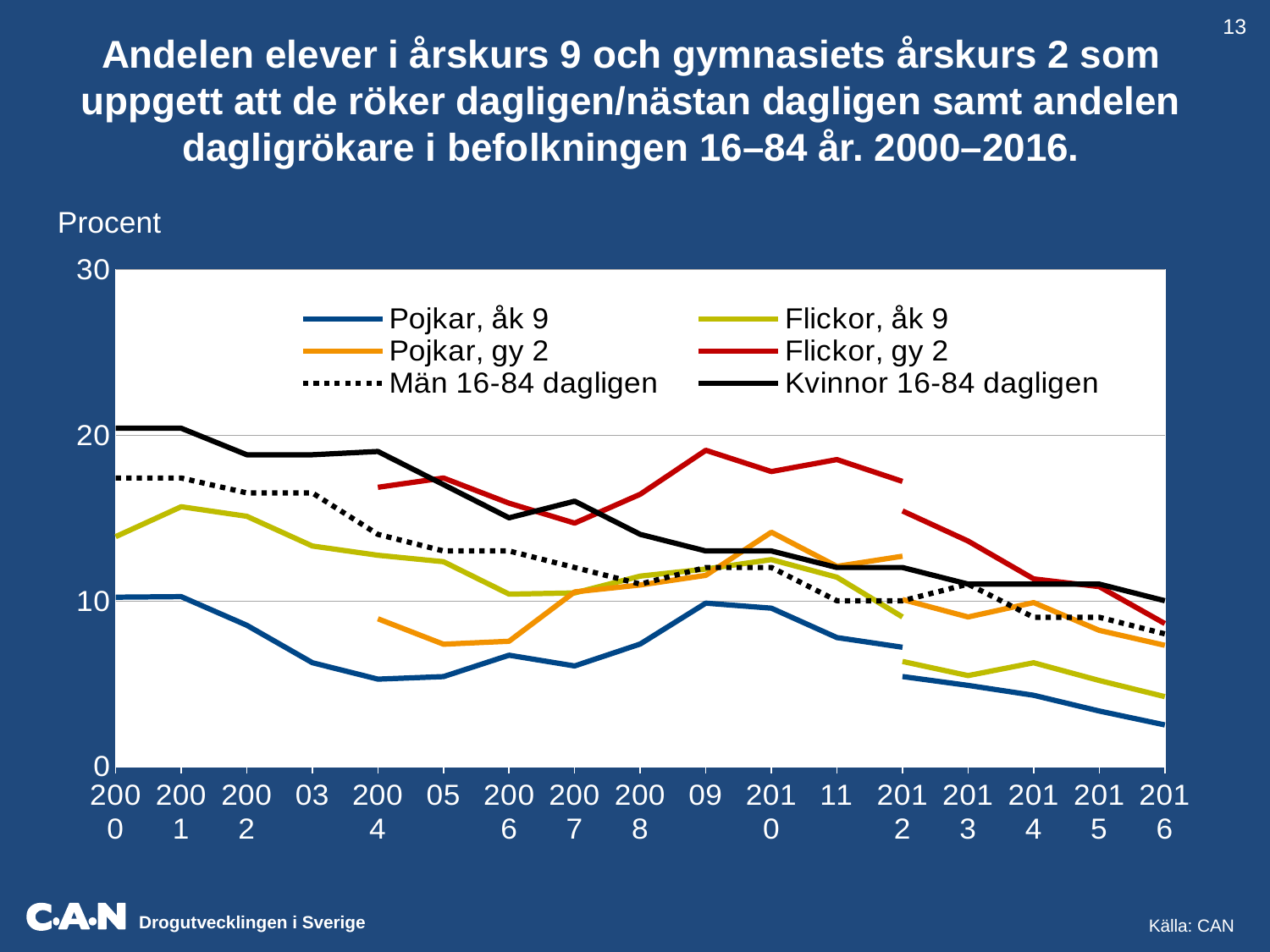
Is the value for Flickor, gy 2 in 2009 greater or less than 10? greater How many series does the legend list? 6 How many years are shown along the x axis? 17 Is the value for Pojkar, gy 2 in 2005 greater or less than 10? less What is the label on the y axis? Procent What kind of chart is shown on the slide? Line chart Is the value for Män 16-84 dagligen in 2000 greater or less than 20? less Which series has the lowest value in 2016? Pojkar, åk 9 In 2009, which is larger: Flickor, gy 2 or Pojkar, åk 9? Flickor, gy 2 Which series is drawn as a dotted line? Män 16-84 dagligen Which series has the highest value in 2009? Flickor, gy 2